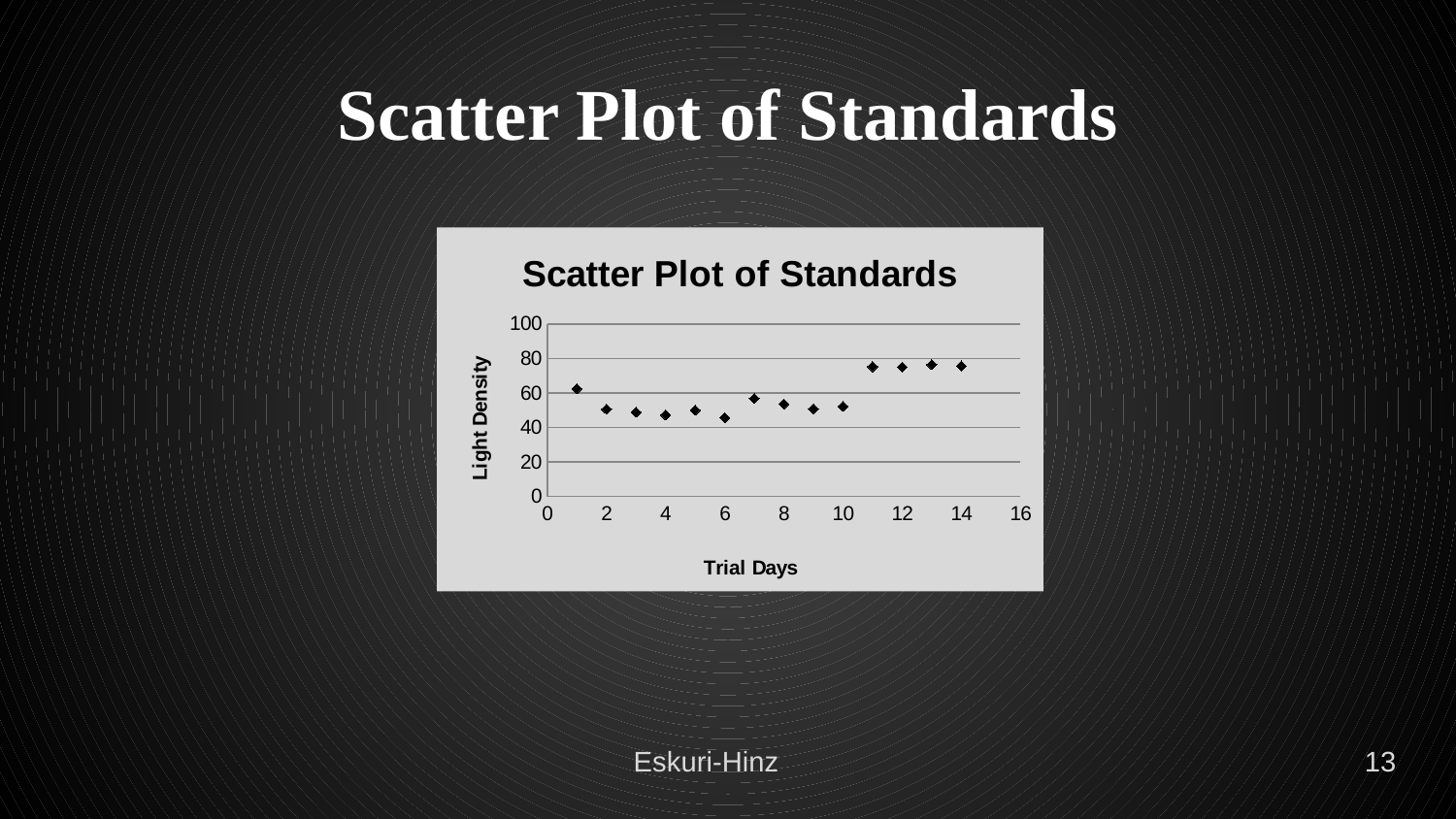
Which has the larger Light Density value, trial day 1 or trial day 4? trial day 1 Is the Light Density value at trial day 2 greater or less than 40? greater Is the Light Density value at trial day 13 greater or less than 60? greater How many data points are plotted in the chart? 14 Which has the larger Light Density value, trial day 6 or trial day 11? trial day 11 What is the title of the chart? Scatter Plot of Standards Do the Light Density values from trial day 10 to trial day 11 rise or fall? rise Is the Light Density value at trial day 12 greater or less than 80? less What kind of chart is shown on the slide? scatter plot What is the label of the y axis? Light Density